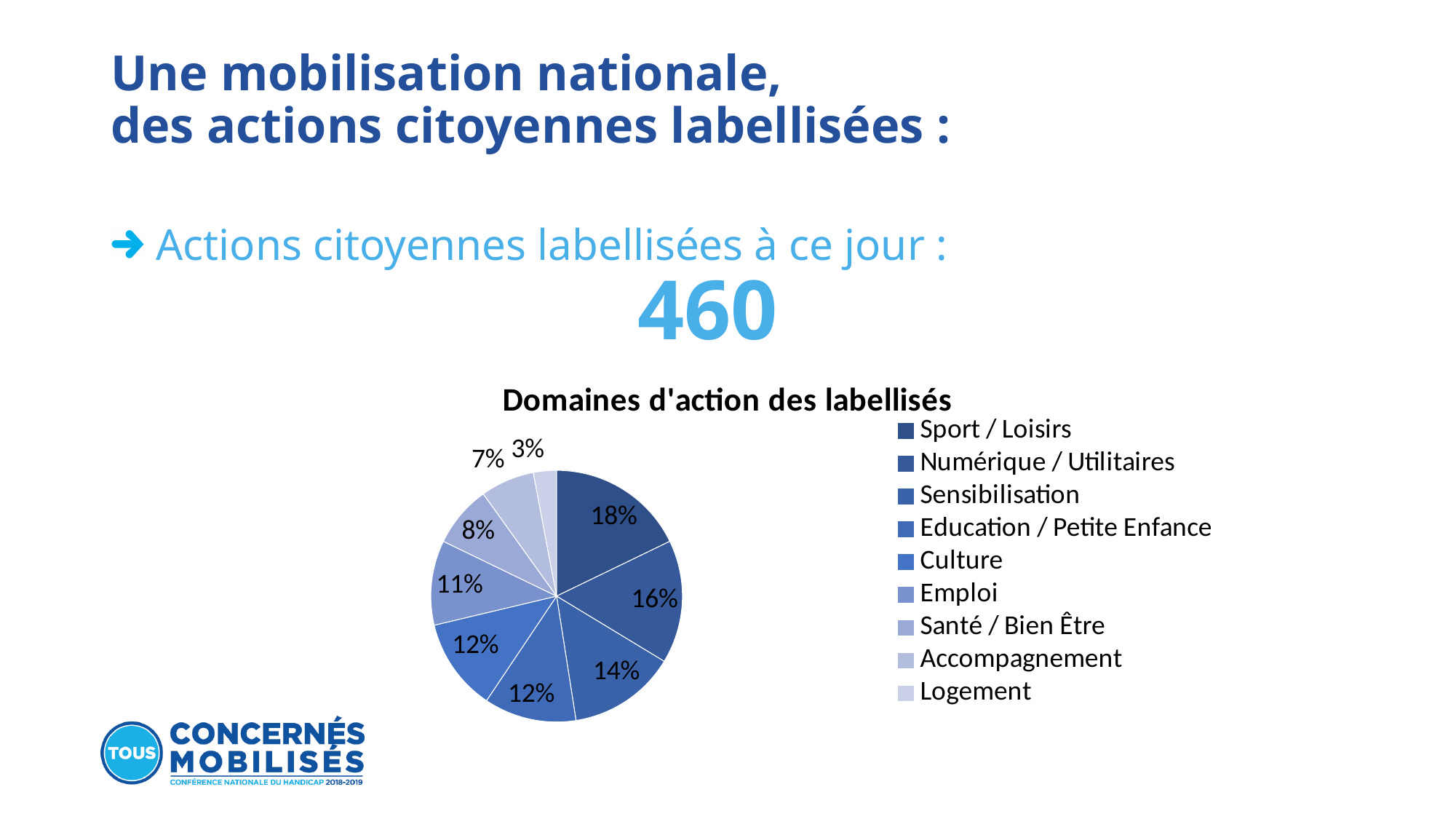
Which category has the smallest slice of the pie? Logement Which category is listed first in the legend? Sport / Loisirs Which is larger, the share for Santé / Bien Être or the share for Accompagnement? Santé / Bien Être How many categories does the pie chart show? 9 What share of the pie does Sport / Loisirs represent? 18% What is the value for Emploi? 11% What kind of chart is shown on the slide? pie chart What is the value for Sensibilisation? 14% What is the difference between the shares of Sport / Loisirs and Logement? 15% What is the title of the chart? Domaines d'action des labellisés What is the value for Numérique / Utilitaires? 16% Which category has the largest slice of the pie? Sport / Loisirs